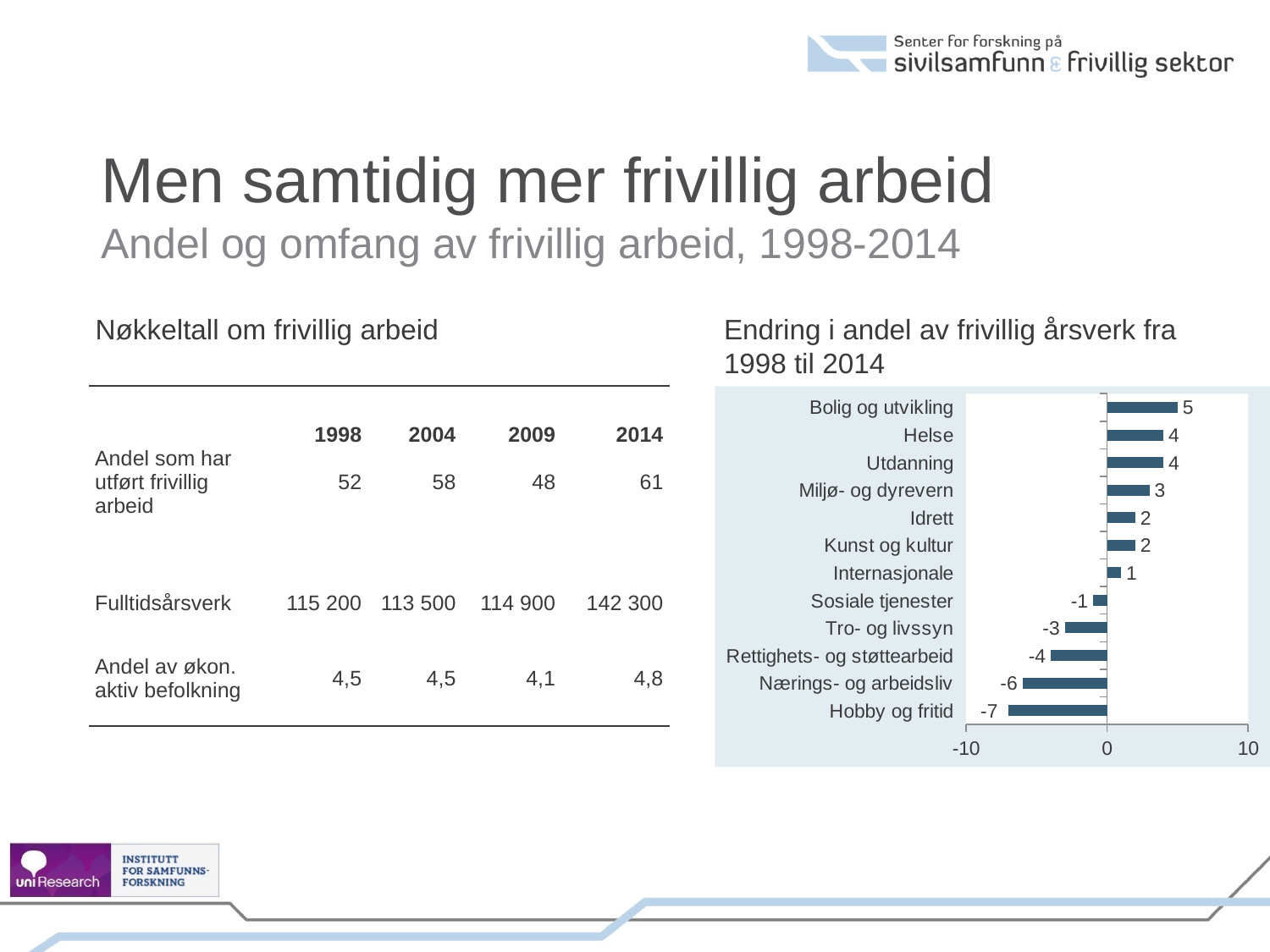
Which category has the lowest value in the chart? Hobby og fritid What is the value for Internasjonale in the chart? 1 What is the value for Bolig og utvikling in the chart? 5 How many categories are shown in the chart? 12 What is the difference between the values for Bolig og utvikling and Hobby og fritid? 12 What is the difference between the values for Helse and Miljø- og dyrevern? 1 Which category has the highest value in the chart? Bolig og utvikling What is the value for Tro- og livssyn in the chart? -3 What is the value for Hobby og fritid in the chart? -7 Which has a larger value, Nærings- og arbeidsliv or Rettighets- og støttearbeid? Rettighets- og støttearbeid What is the title of the chart on the slide? Endring i andel av frivillig årsverk fra 1998 til 2014 What kind of chart is shown on the slide? Bar chart